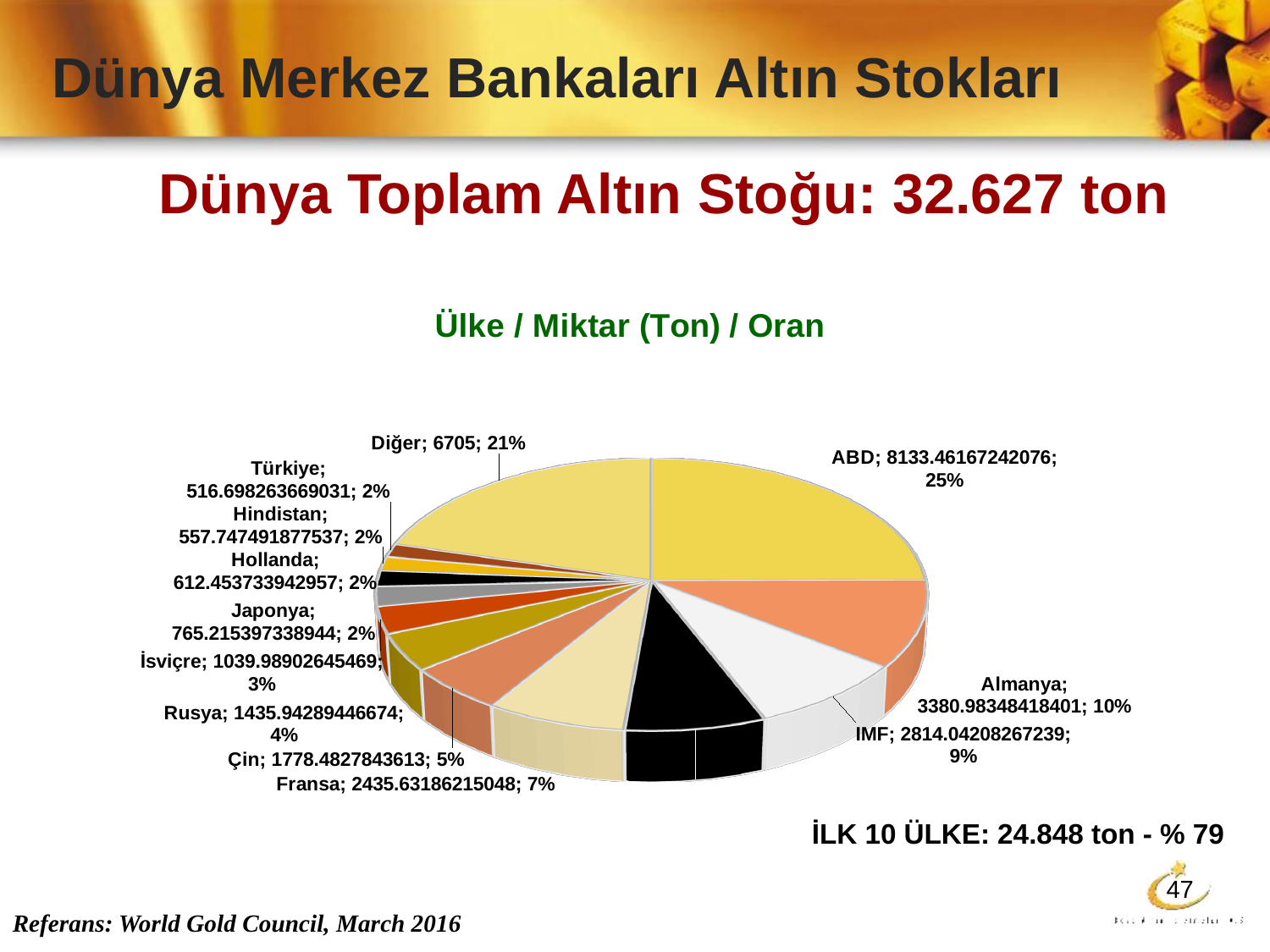
What percentage share of the pie does Almanya hold? 10% What is the value shown for Rusya? 1435.94289446674 Which slice has the lowest value in the pie chart? Türkiye What is the title of the pie chart? Ülke / Miktar (Ton) / Oran What percentage share does Fransa hold in the pie? 7% How many slices does the pie chart have? 13 What kind of chart is shown on the slide? pie chart Which named country slice has the highest value in the pie chart? ABD What percentage share does Diğer hold in the pie? 21% What value is shown for IMF? 2814.04208267239 What is the gold stock value shown for ABD? 8133.46167242076 Which is larger, the value for Fransa or the value for Çin? Fransa